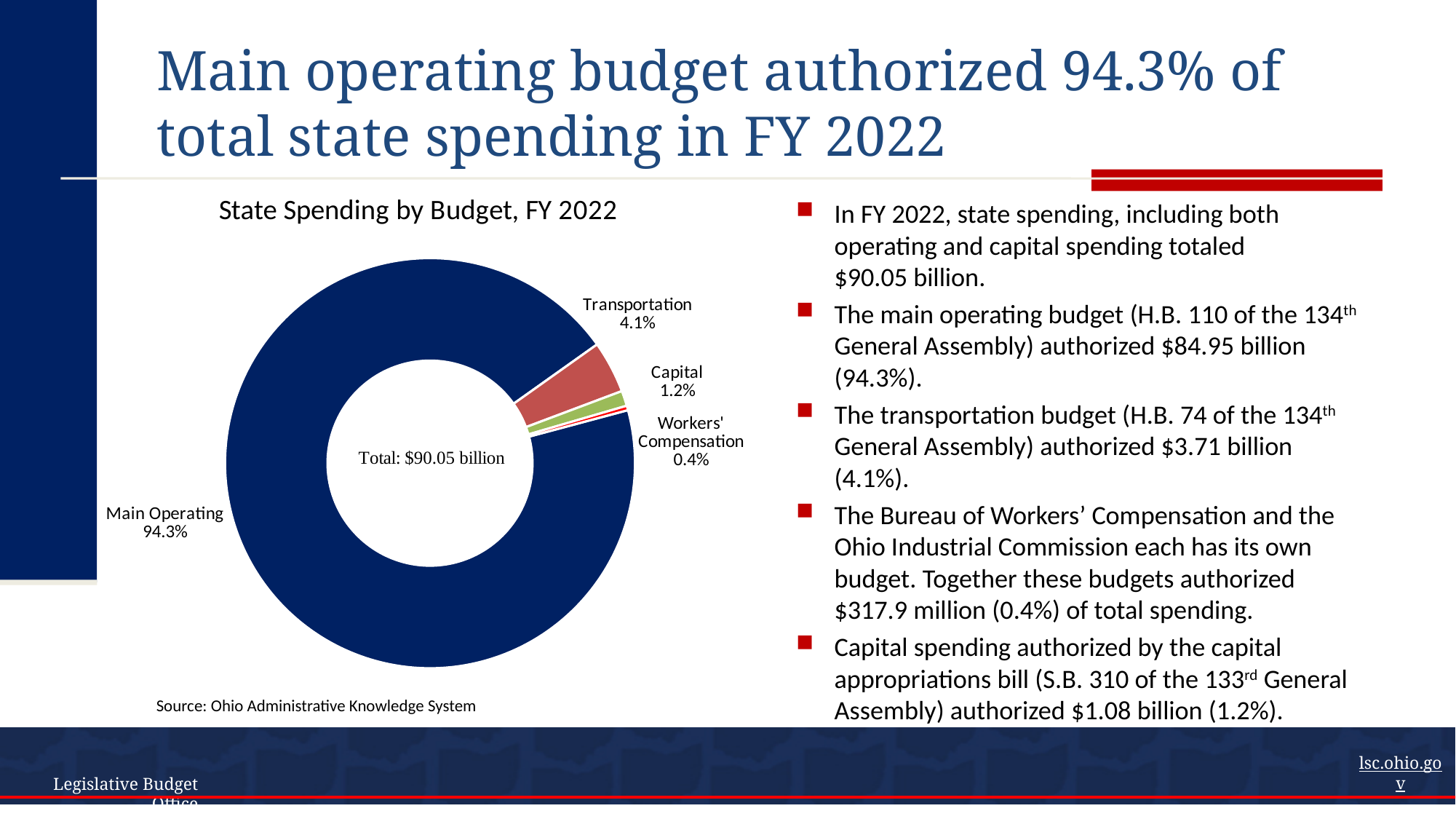
What percentage of state spending is shown for Transportation? 4.1% Which has a larger share of state spending, Capital or Transportation? Transportation What share of state spending does the Main Operating budget account for in the chart? 94.3% How many budget categories are shown in the chart? 4 What percentage of state spending is shown for Workers' Compensation? 0.4% What is the title of the chart? State Spending by Budget, FY 2022 Which budget category has the largest share of state spending in the chart? Main Operating Which budget category has the smallest share of state spending in the chart? Workers' Compensation What is the difference in percentage points between the Transportation and Capital shares? 2.9 percentage points What kind of chart is used to show State Spending by Budget, FY 2022? Pie chart (doughnut) What percentage of state spending is shown for Capital? 1.2% What total is printed in the center of the chart? Total: $90.05 billion